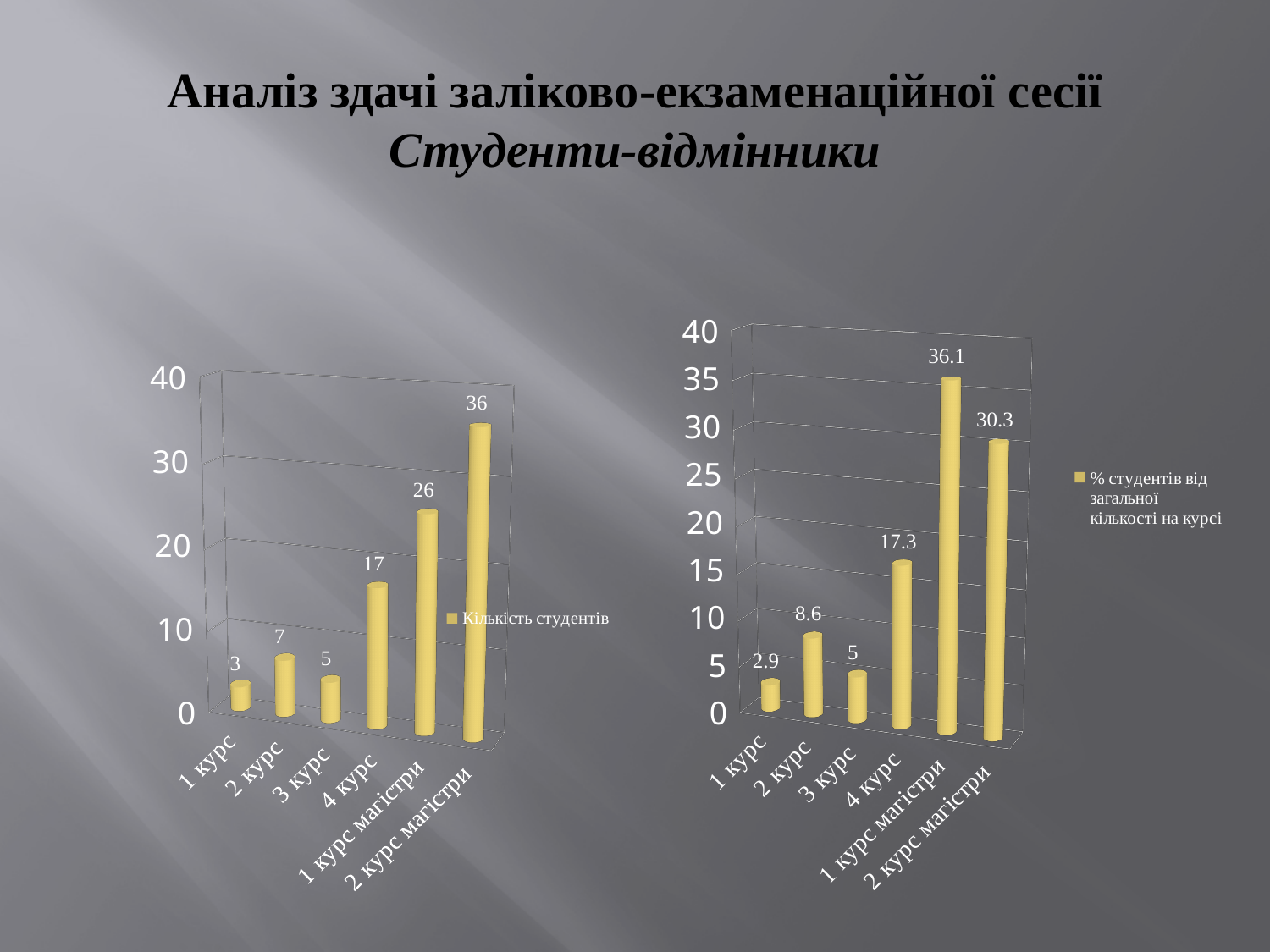
In the left chart (Кількість студентів), how many categories are shown on the x axis? 6 In the right chart (% студентів від загальної кількості на курсі), what is the value for 2 курс? 8.6 In the right chart (% студентів від загальної кількості на курсі), which is larger: the value for 3 курс or the value for 2 курс? 2 курс In the left chart (Кількість студентів), what is the value for 4 курс? 17 What kind of chart is the left chart (Кількість студентів)? bar chart How many series does the legend of the right chart list? 1 In the right chart (% студентів від загальної кількості на курсі), which category has the highest value? 1 курс магістри In the left chart (Кількість студентів), what is the difference between the values for 2 курс магістри and 1 курс магістри? 10 In the left chart (Кількість студентів), which category has the highest value? 2 курс магістри In the right chart (% студентів від загальної кількості на курсі), what is the difference between the values for 1 курс магістри and 4 курс? 18.8 In the left chart (Кількість студентів), which category has the lowest value? 1 курс In the right chart (% студентів від загальної кількості на курсі), which category has the lowest value? 1 курс